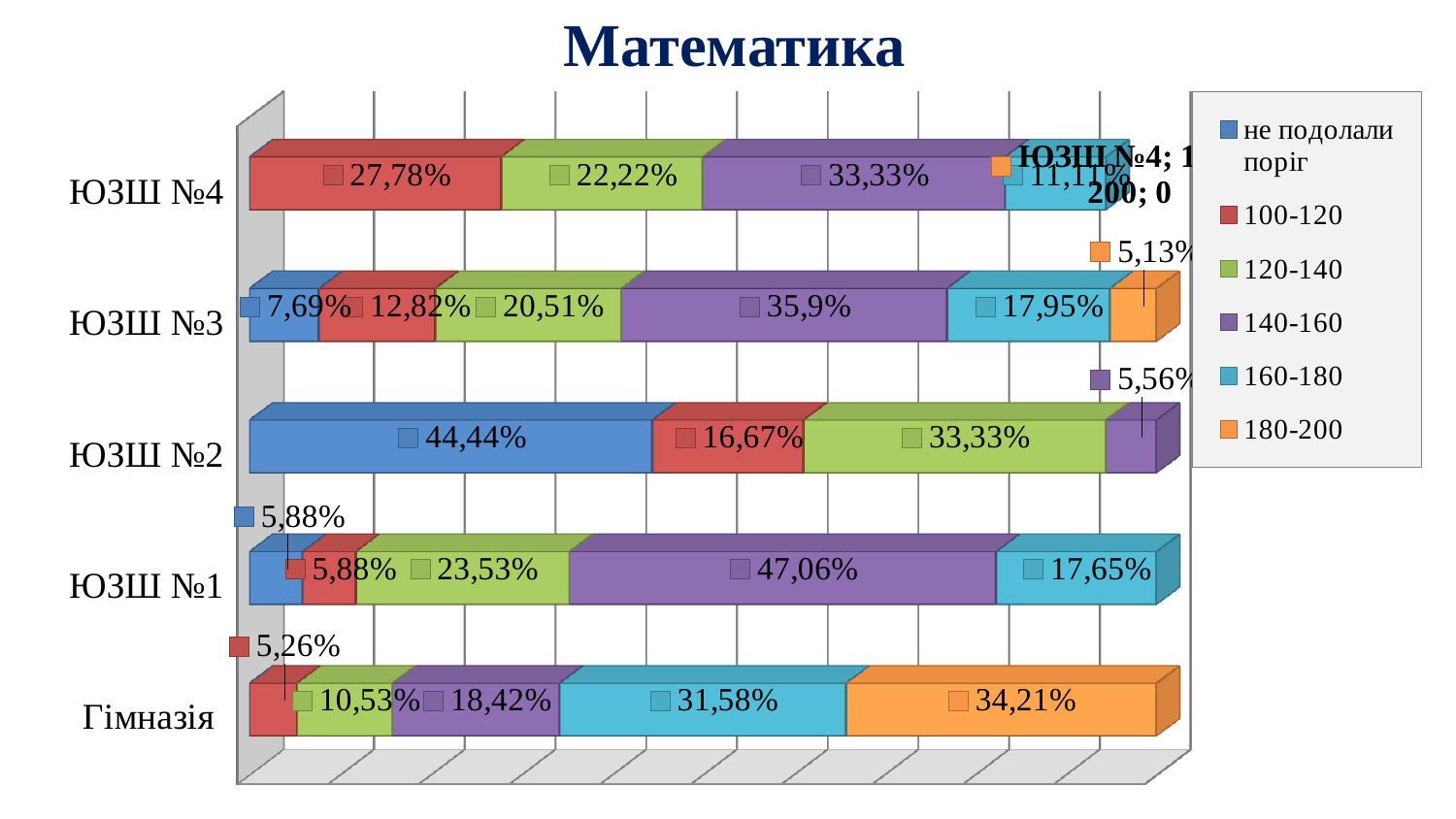
What is the title of the chart? Математика What is the value of the 160-180 segment for ЮЗШ №3? 17,95% Which is larger: the 100-120 value for ЮЗШ №4 or for ЮЗШ №3? ЮЗШ №4 What is the difference between the 140-160 values for ЮЗШ №3 and ЮЗШ №4? 2,57% What kind of chart is shown on the slide? Stacked bar chart How many schools (categories) are shown on the chart? 5 What is the value of the 'не подолали поріг' segment for ЮЗШ №2? 44,44% Which school has the highest 'не подолали поріг' share? ЮЗШ №2 What is the value of the 180-200 segment for Гімназія? 34,21% How many series does the legend list? 6 What is the value of the 140-160 segment for ЮЗШ №1? 47,06% Which school has the highest 180-200 share? Гімназія